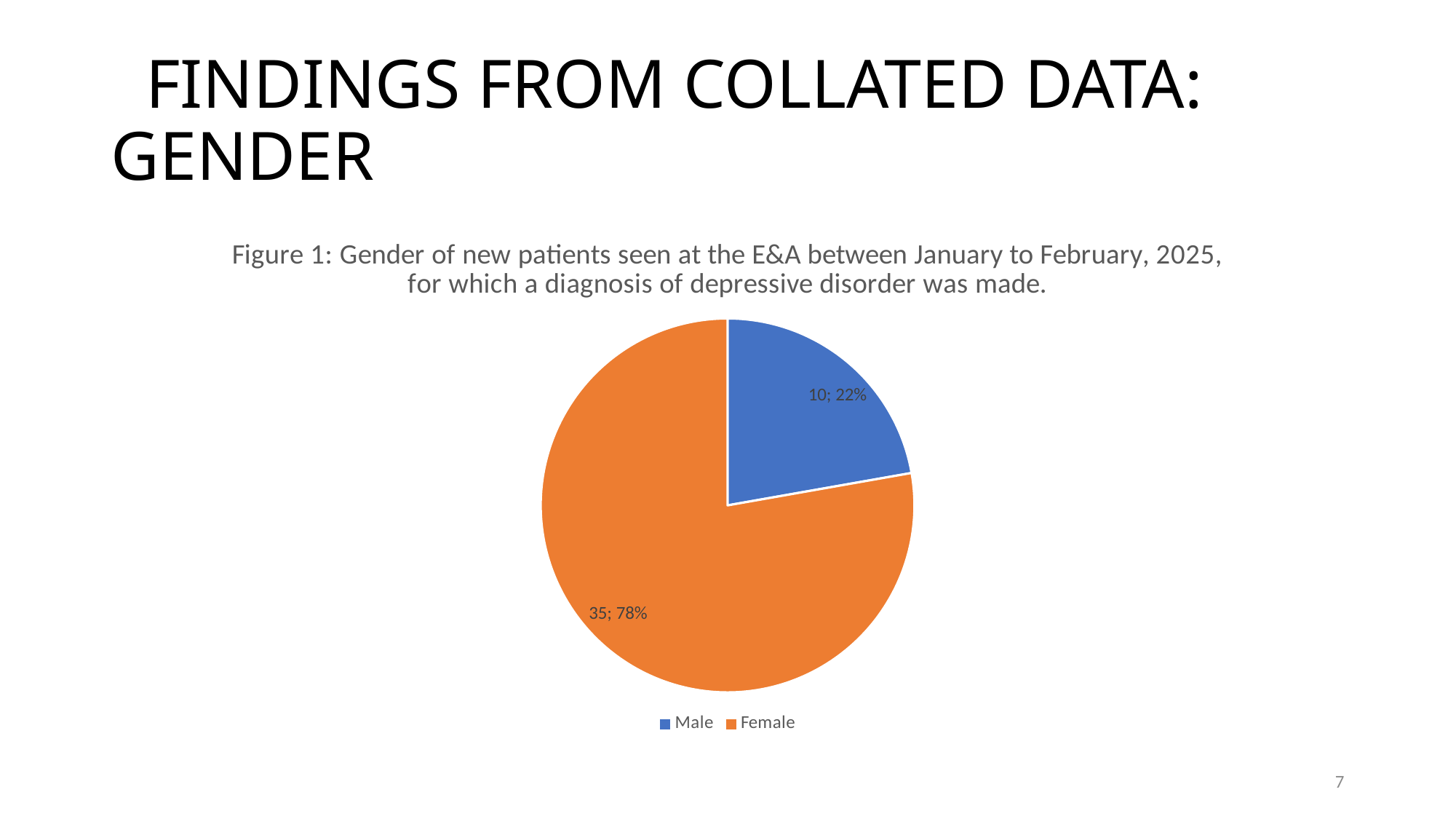
Which gender has the smallest slice of the pie? Male What colour is the Female slice of the pie chart? orange How many patients were Female? 35 How many slices does the pie chart have? 2 What is the total number of patients shown in the pie chart? 45 Which gender has the largest slice of the pie? Female What share of the pie does the Male slice represent? 22% What share of the pie does the Female slice represent? 78% How many more Female patients were there than Male patients? 25 What kind of chart is shown on the slide? pie chart Which is larger, the number of Male patients or the number of Female patients? Female How many patients were Male? 10